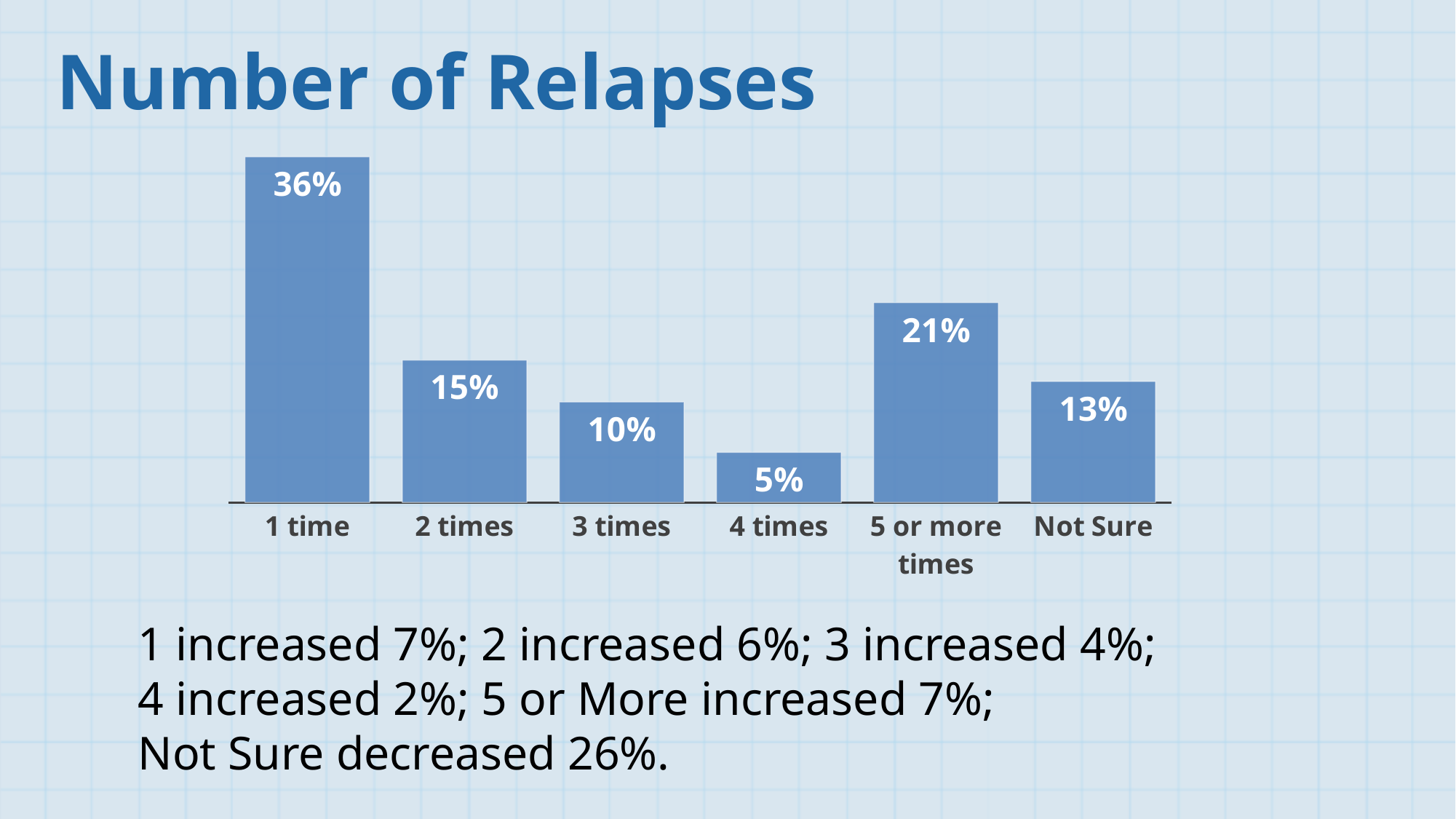
What is the value for Not Sure? 13% What kind of chart is shown on the slide? bar chart Do the values rise or fall from 1 time to 4 times? fall Which category has the lowest value? 4 times Which category has the highest value? 1 time What is the value for 5 or more times? 21% What is the difference between the values for 5 or more times and Not Sure? 8% What is the difference between the values for 1 time and 2 times? 21% What is the value for 1 time? 36% How many categories are shown on the x axis? 6 Which is larger, the value for 3 times or the value for Not Sure? Not Sure What is the title of the slide? Number of Relapses